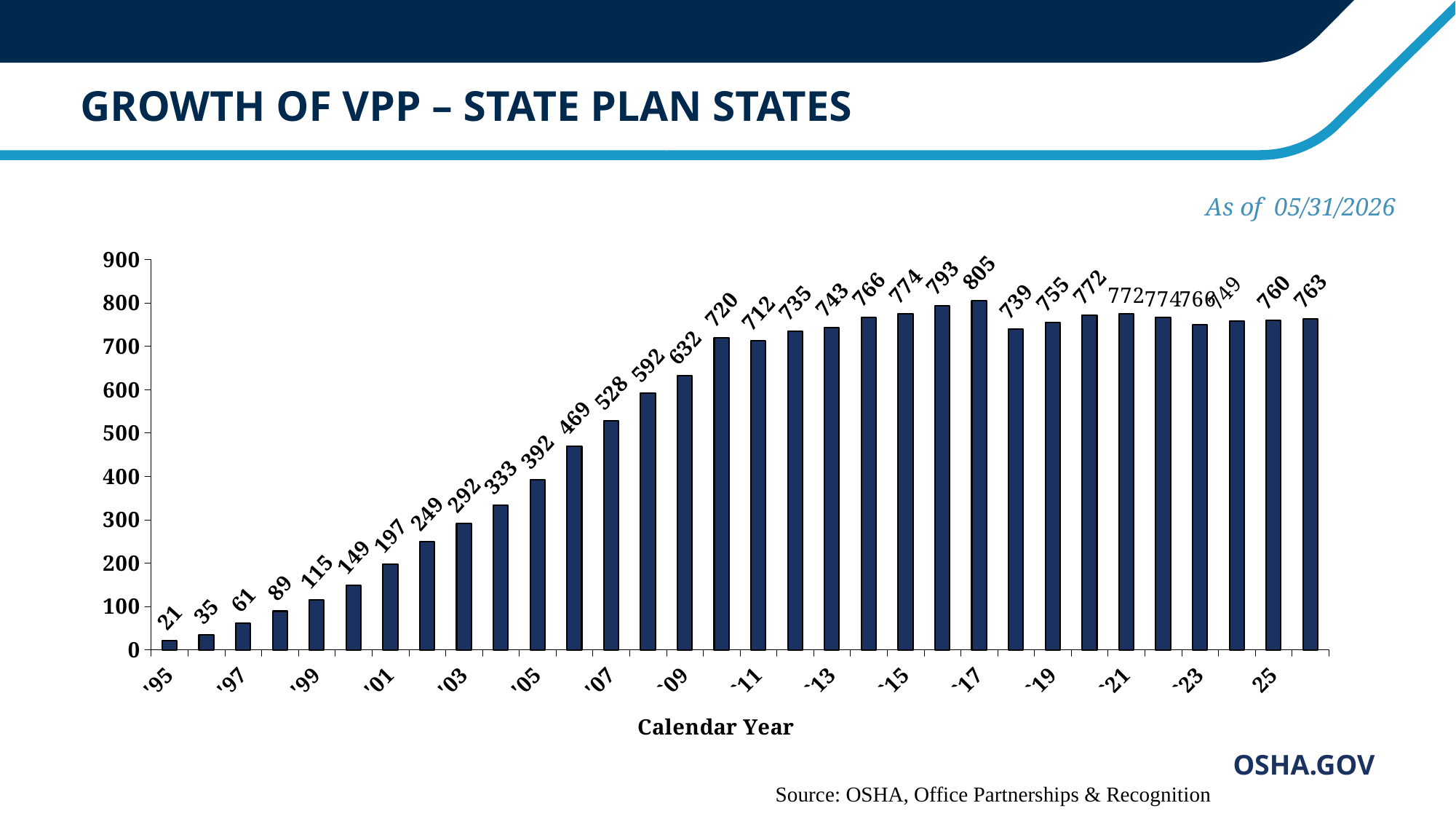
What is the value for '25? 760 What is the difference between the values for '17 and '95? 784 Which is larger, the value for '09 or the value for '11? '11 What is the value for '05? 392 What is the value for '17? 805 Which year has the lowest value? '95 What is the x-axis title of the chart? Calendar Year What type of chart is shown on the slide? bar chart Is the value for '07 greater or less than 500? greater What is the value for '95? 21 Which year has the highest value? '17 Do the values generally rise or fall from '95 to '17? rise